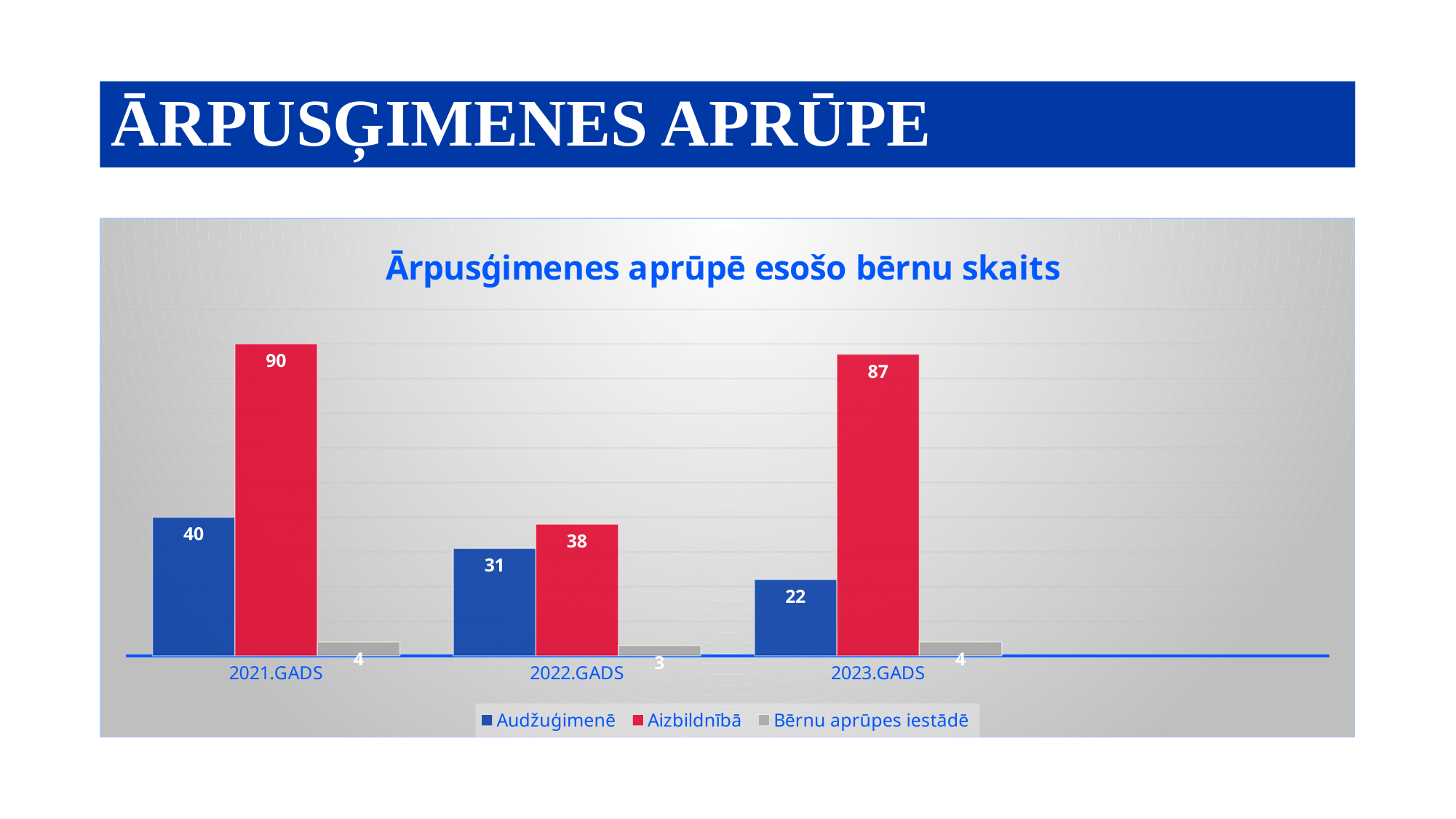
What is the title of the chart? Ārpusģimenes aprūpē esošo bērnu skaits What is the difference between the Aizbildnībā values for 2021.GADS and 2022.GADS? 52 Which year has the lowest value for Aizbildnībā? 2022.GADS What is the value for Aizbildnībā in 2021.GADS? 90 Which year has the highest value for Audžuģimenē? 2021.GADS How many series does the legend list? 3 Which is larger in 2022.GADS: Audžuģimenē or Aizbildnībā? Aizbildnībā What is the value for Audžuģimenē in 2023.GADS? 22 What is the value for Bērnu aprūpes iestādē in 2022.GADS? 3 What kind of chart is shown on the slide? bar chart Does the Audžuģimenē value rise or fall from 2021.GADS to 2023.GADS? fall How many years are shown on the x axis? 3